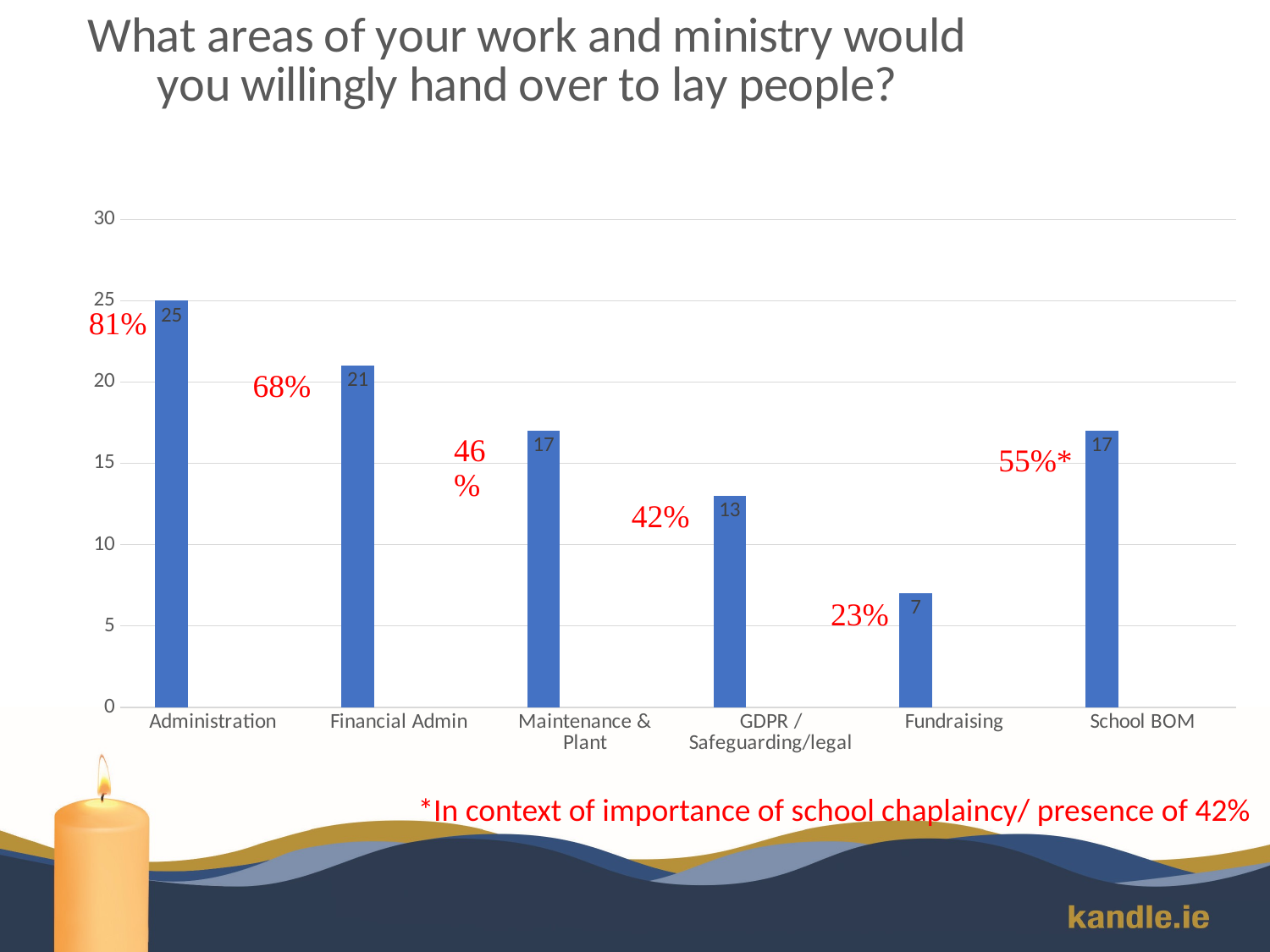
Which is larger, the value for Financial Admin or the value for GDPR / Safeguarding/legal? Financial Admin What is the value for Administration? 25 What kind of chart is shown on the slide? Bar chart What is the value for Fundraising? 7 What is the difference between the values for Administration and Financial Admin? 4 How many categories are shown on the x axis? 6 Which category has the lowest value? Fundraising Which category has the highest value? Administration What is the value for GDPR / Safeguarding/legal? 13 What is the value for Financial Admin? 21 What red percentage is written next to the Administration bar? 81% What is the difference between the values for School BOM and Fundraising? 10